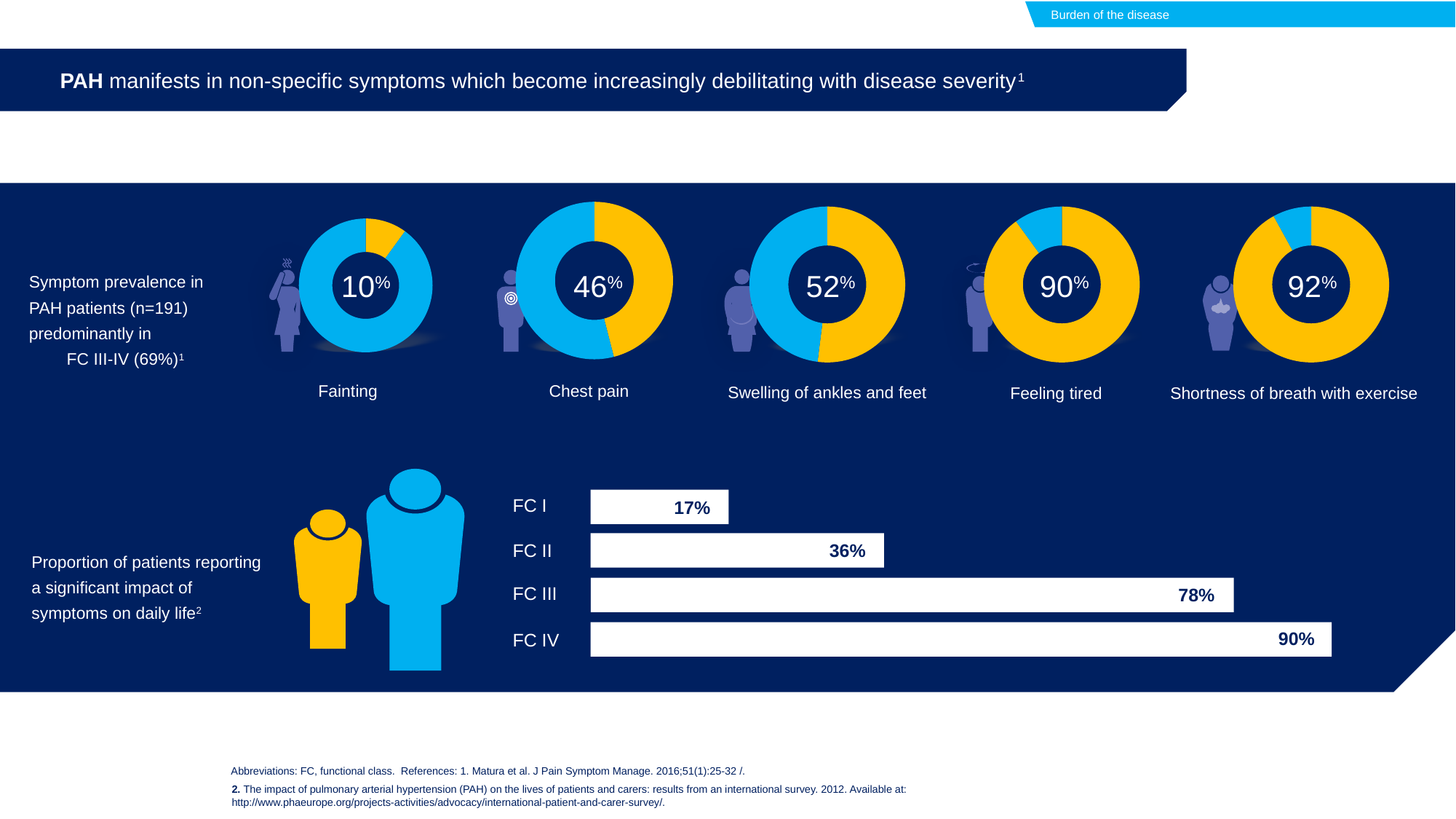
In the bar chart showing the proportion of patients reporting a significant impact of symptoms on daily life, what is the difference between FC III and FC I? 61% Among the symptom prevalence donut charts, which symptom has the lowest prevalence? Fainting In the symptom prevalence donut charts, what is the prevalence of chest pain? 46% In the bar chart showing the proportion of patients reporting a significant impact of symptoms on daily life, what is the value for FC II? 36% In the symptom prevalence donut charts, what percentage of PAH patients report shortness of breath with exercise? 92% In the bar chart showing the proportion of patients reporting a significant impact of symptoms on daily life, do the values rise or fall from FC I to FC IV? Rise Among the symptom prevalence donut charts, which symptom has the highest prevalence? Shortness of breath with exercise In the symptom prevalence donut charts, what is the prevalence of fainting in PAH patients? 10% What kind of chart is used to show the proportion of patients reporting a significant impact of symptoms on daily life? Bar chart In the symptom prevalence donut charts, what is the difference between the prevalence of feeling tired and the prevalence of chest pain? 44% In the bar chart showing the proportion of patients reporting a significant impact of symptoms on daily life, which functional class has the highest value? FC IV How many symptom prevalence donut charts are shown on the slide? 5